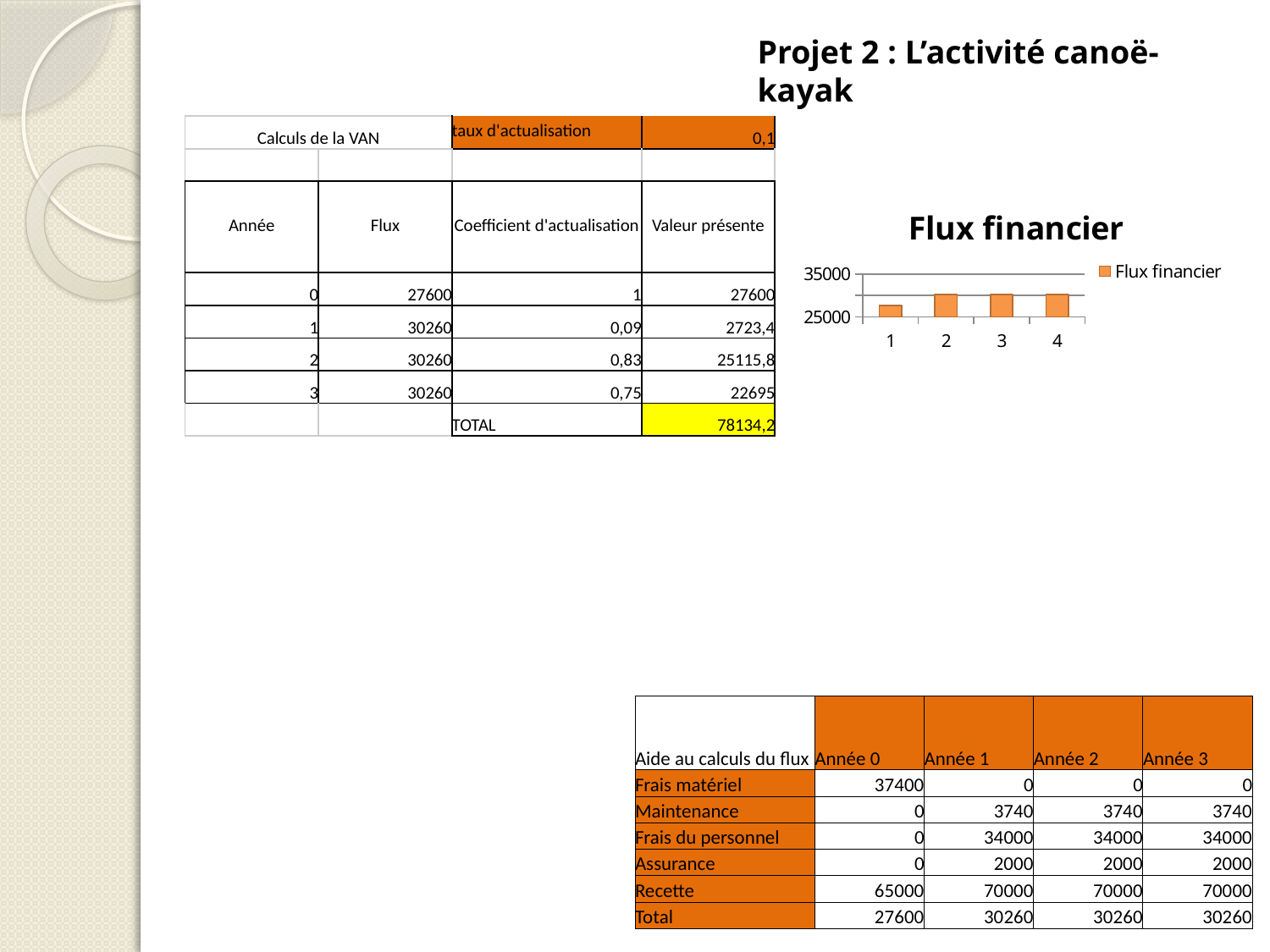
In the "Flux financier" chart, is the bar for category 4 greater or less than 35000? less What type of chart is the "Flux financier" chart? bar chart How many bars are plotted in the "Flux financier" chart? 4 In the "Flux financier" chart, which is larger, the bar for category 1 or the bar for category 2? 2 In the "Flux financier" chart, does the value rise or fall from category 1 to category 2? rise What is the title of the chart on the slide? Flux financier In the "Flux financier" chart, which category has the lowest bar? 1 How many series does the legend of the "Flux financier" chart list? 1 In the "Flux financier" chart, which is larger, the bar for category 1 or the bar for category 4? 4 In the "Flux financier" chart, is the bar for category 2 greater or less than 35000? less What is the name of the series shown in the legend of the "Flux financier" chart? Flux financier In the "Flux financier" chart, is the bar for category 1 greater or less than 25000? greater